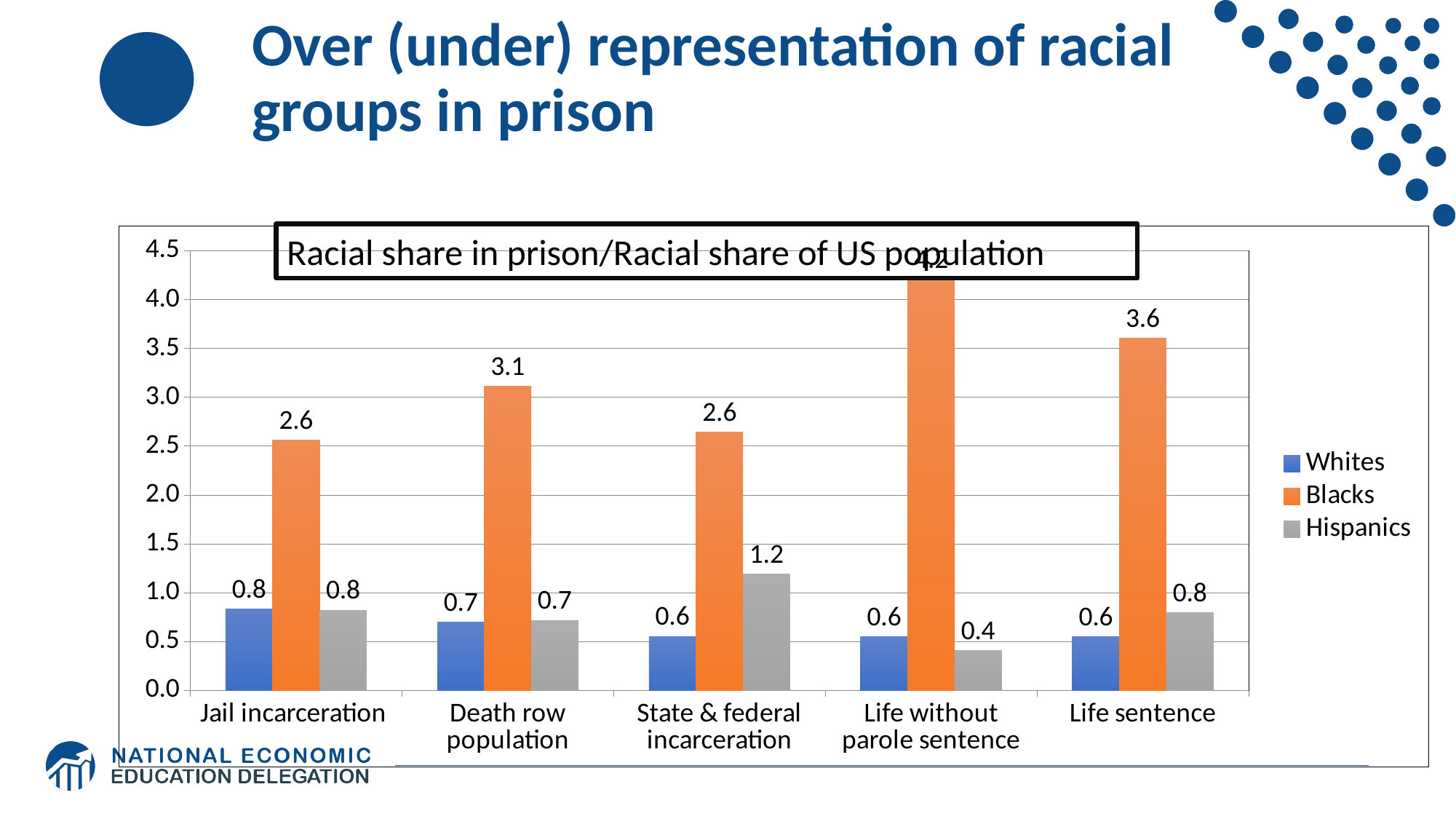
In which category is the value for Hispanics lowest? Life without parole sentence What is the value for Blacks in the Death row population category? 3.1 Is the value for Blacks in the Life without parole sentence category greater or less than 4.0? greater What type of chart is shown on the slide? bar chart How many series does the legend list? 3 How many categories are shown on the x axis? 5 What is the value for Hispanics in the State & federal incarceration category? 1.2 Which is larger in the State & federal incarceration category, the value for Whites or the value for Hispanics? Hispanics What is the difference between the Blacks value and the Whites value in the Life sentence category? 3.0 What is the value for Whites in the Jail incarceration category? 0.8 In which category is the value for Blacks highest? Life without parole sentence What is the value for Hispanics in the Life without parole sentence category? 0.4